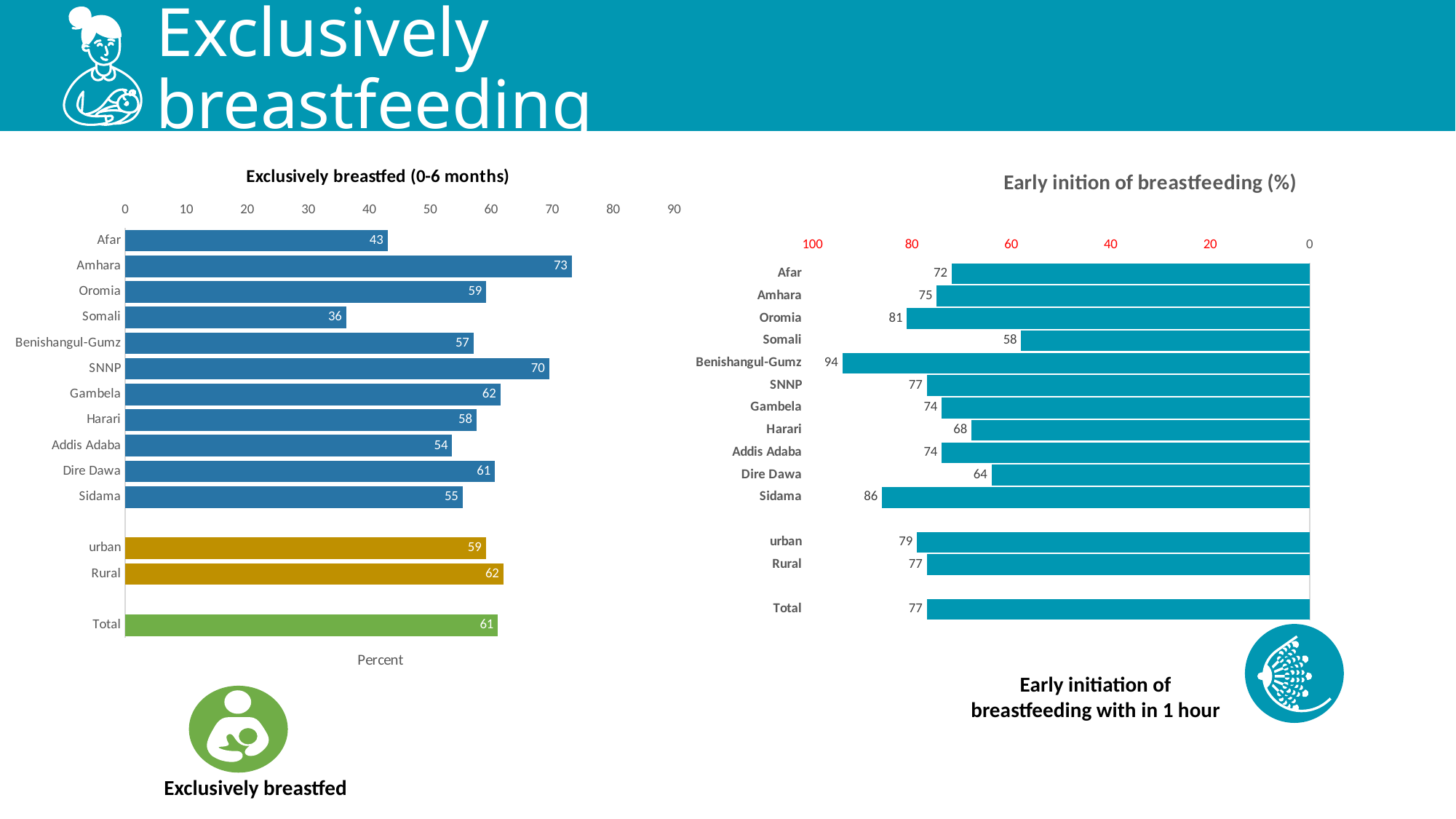
In the 'Early inition of breastfeeding (%)' chart, which region has the lowest value? Somali In the 'Early inition of breastfeeding (%)' chart, what is the value for urban? 79 In the 'Exclusively breastfed (0-6 months)' chart, what is the Total value? 61 In the 'Early inition of breastfeeding (%)' chart, which region has the highest value? Benishangul-Gumz What type of chart is the 'Exclusively breastfed (0-6 months)' chart? Bar chart In the 'Exclusively breastfed (0-6 months)' chart, which is larger, SNNP or Gambela? SNNP In the 'Exclusively breastfed (0-6 months)' chart, which region has the lowest value? Somali In the 'Early inition of breastfeeding (%)' chart, what is the value for Benishangul-Gumz? 94 In the 'Early inition of breastfeeding (%)' chart, what is the difference between Sidama and Dire Dawa? 22 In the 'Exclusively breastfed (0-6 months)' chart, what is the value for Amhara? 73 In the 'Exclusively breastfed (0-6 months)' chart, what is the difference between the Rural and urban values? 3 How many regions (excluding urban, Rural and Total) are shown in the 'Early inition of breastfeeding (%)' chart? 11